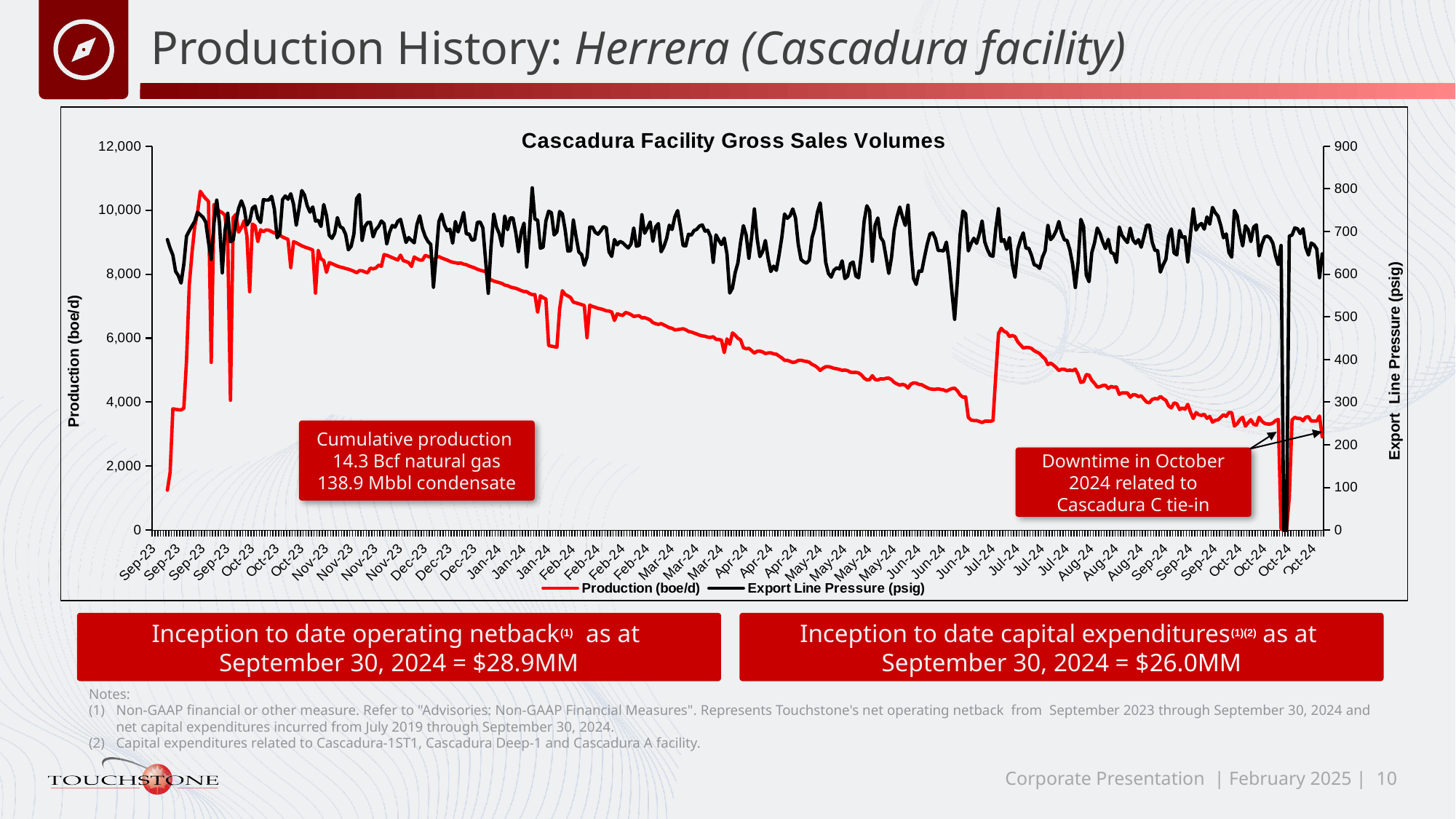
Is the Production (boe/d) value at the end of Oct-24 greater or less than 4,000? less According to the annotation on the chart, what is the cumulative natural gas production? 14.3 Bcf What kind of chart is shown on the slide? Line chart Is the Production (boe/d) value just before the jump in Jul-24 greater or less than 4,000? less Is the Export Line Pressure (psig) value at the start of Sep-23 greater or less than 600? greater What is the title of the chart? Cascadura Facility Gross Sales Volumes Does the Production (boe/d) line generally rise or fall between Dec-23 and Jun-24? Fall Which series is drawn in red on the chart? Production (boe/d) What is the highest value shown on the right-hand Export Line Pressure (psig) axis? 900 How many series does the chart legend list? 2 What is the highest value shown on the left-hand Production (boe/d) axis? 12,000